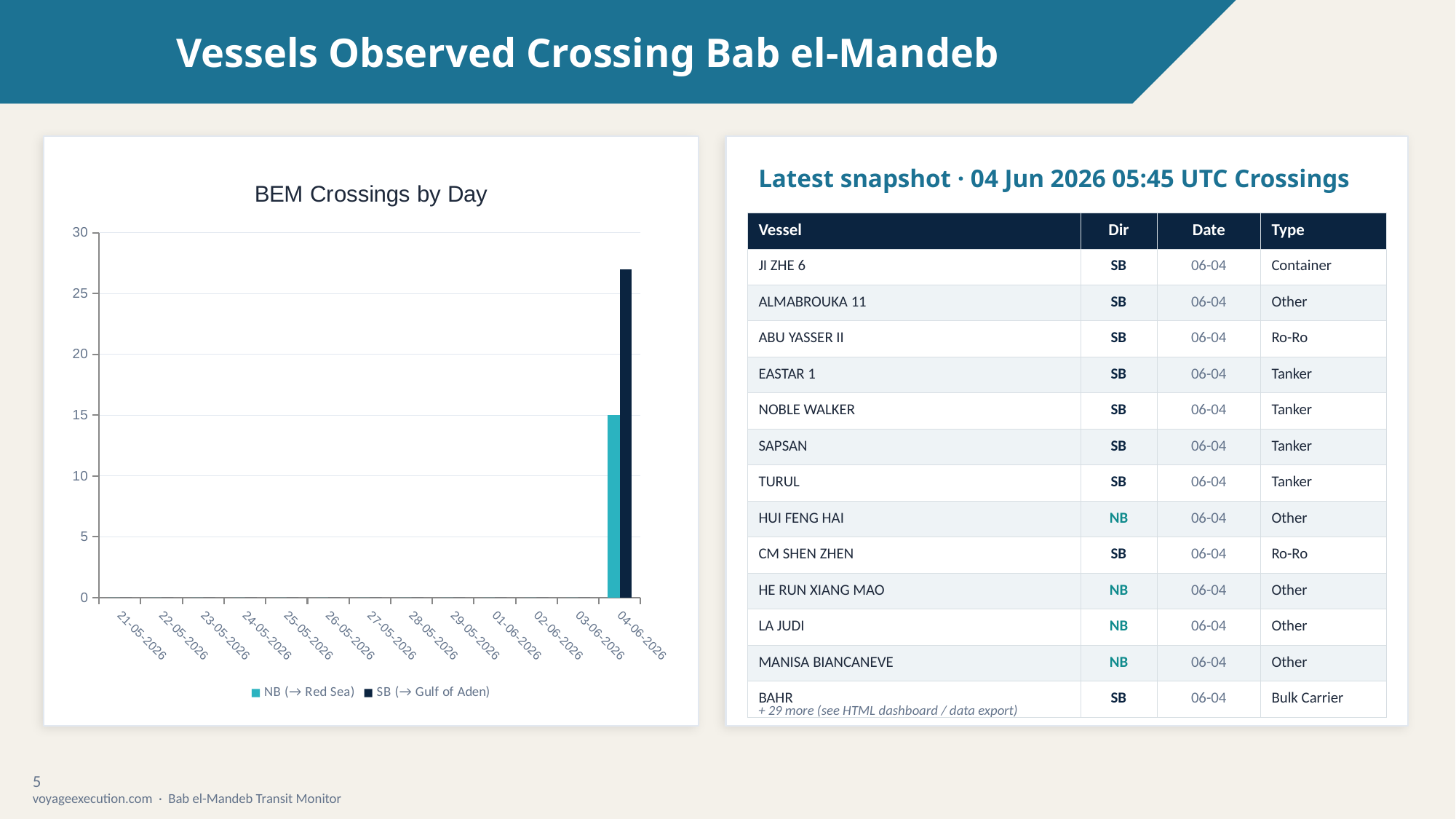
In "BEM Crossings by Day", is the NB (→ Red Sea) value for 04-06-2026 greater or less than 10? greater In "BEM Crossings by Day", what is the NB (→ Red Sea) value for 04-06-2026? 15 In "BEM Crossings by Day", do the SB (→ Gulf of Aden) values rise or fall from 03-06-2026 to 04-06-2026? rise How many series does the legend of "BEM Crossings by Day" list? 2 In "BEM Crossings by Day", is the SB (→ Gulf of Aden) value for 03-06-2026 greater or less than 5? less In "BEM Crossings by Day", which series has the larger value on 04-06-2026, NB (→ Red Sea) or SB (→ Gulf of Aden)? SB (→ Gulf of Aden) In "BEM Crossings by Day", is the SB (→ Gulf of Aden) value for 04-06-2026 greater or less than 25? greater In "BEM Crossings by Day", which date has the highest SB (→ Gulf of Aden) value? 04-06-2026 How many dates are shown on the x axis of "BEM Crossings by Day"? 13 What are the two legend entries in "BEM Crossings by Day"? NB (→ Red Sea) and SB (→ Gulf of Aden) What is the title of the chart on the left of the slide? BEM Crossings by Day What kind of chart is "BEM Crossings by Day"? bar chart